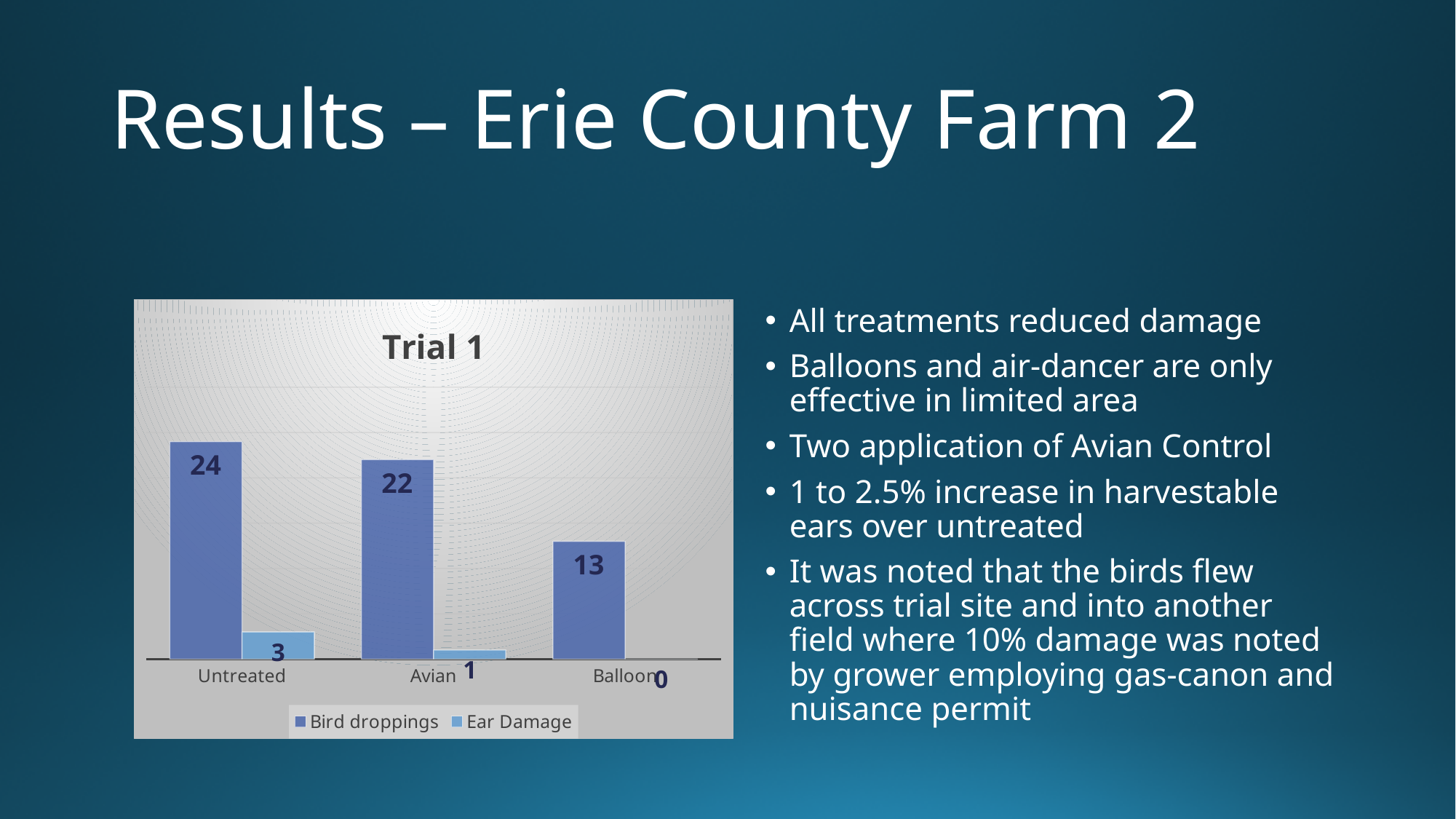
What is the title of the chart? Trial 1 What is the Bird droppings value for Balloon? 13 Which category has the highest Bird droppings value? Untreated How many categories are shown on the x axis? 3 How many series does the legend list? 2 Which is larger, the Bird droppings value for Avian or for Balloon? Avian What is the difference in Bird droppings between Untreated and Balloon? 11 What is the Ear Damage value for Avian? 1 What is the Ear Damage value for Balloon? 0 What kind of chart is shown? Bar chart Which category has the lowest Ear Damage value? Balloon What is the Bird droppings value for Untreated? 24